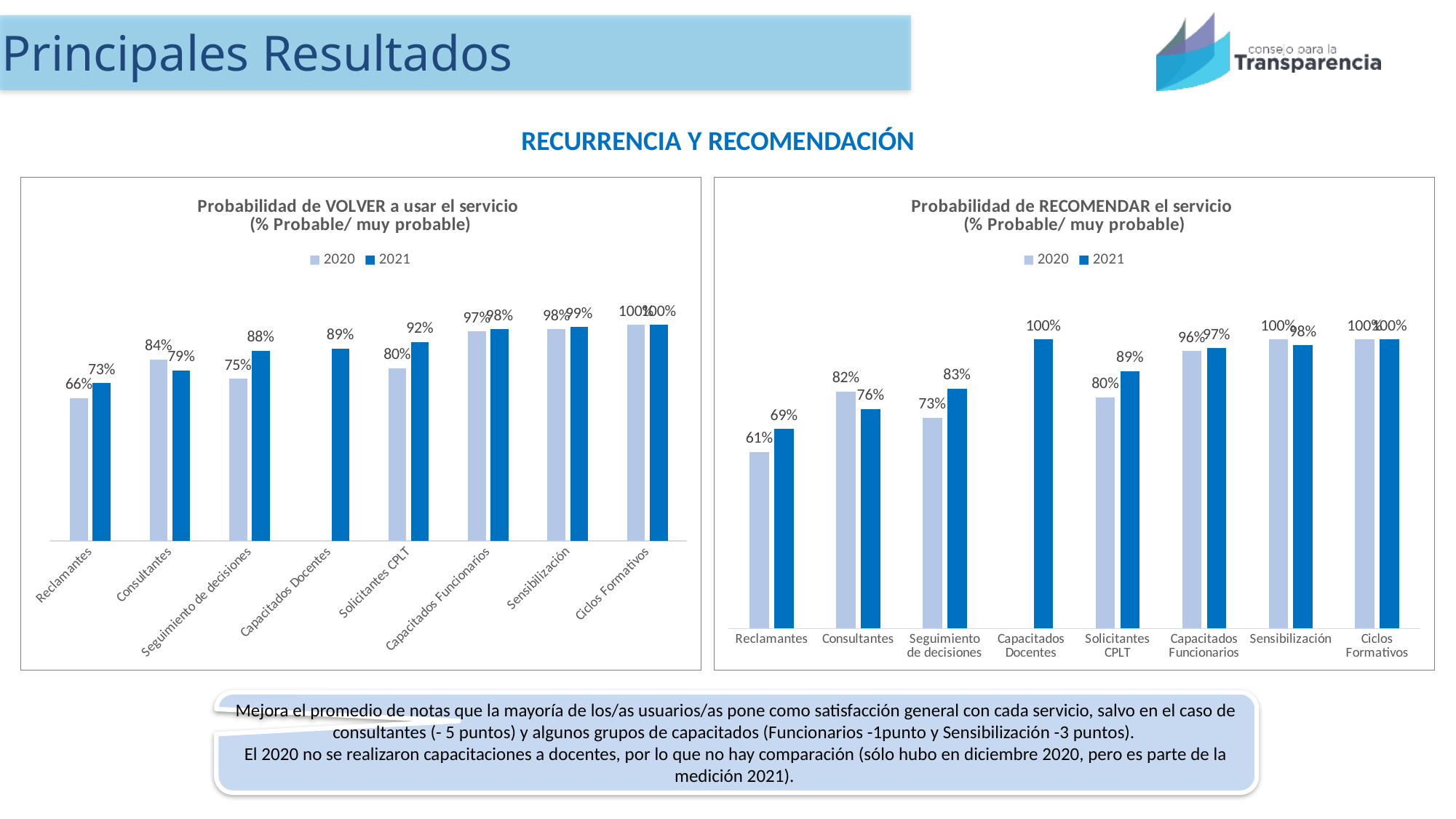
In the 'Probabilidad de VOLVER a usar el servicio' chart, how many series does the legend list? 2 In the 'Probabilidad de VOLVER a usar el servicio' chart, which is larger for Consultantes, the 2020 value or the 2021 value? 2020 In the 'Probabilidad de RECOMENDAR el servicio' chart, how many categories are shown on the x axis? 8 In the 'Probabilidad de VOLVER a usar el servicio' chart, what is the 2021 value for Reclamantes? 73% What type of chart is the 'Probabilidad de RECOMENDAR el servicio' chart? Bar chart In the 'Probabilidad de RECOMENDAR el servicio' chart, which is larger for Sensibilización, the 2020 value or the 2021 value? 2020 In the 'Probabilidad de RECOMENDAR el servicio' chart, what is the 2020 value for Reclamantes? 61% In the 'Probabilidad de RECOMENDAR el servicio' chart, what is the difference between the 2020 and 2021 values for Consultantes? 6% In the 'Probabilidad de VOLVER a usar el servicio' chart, what is the difference between the 2021 and 2020 values for Seguimiento de decisiones? 13% In the 'Probabilidad de RECOMENDAR el servicio' chart, what is the 2021 value for Solicitantes CPLT? 89% In the 'Probabilidad de VOLVER a usar el servicio' chart, which category has the lowest 2020 value? Reclamantes In the 'Probabilidad de VOLVER a usar el servicio' chart, what is the 2020 value for Consultantes? 84%